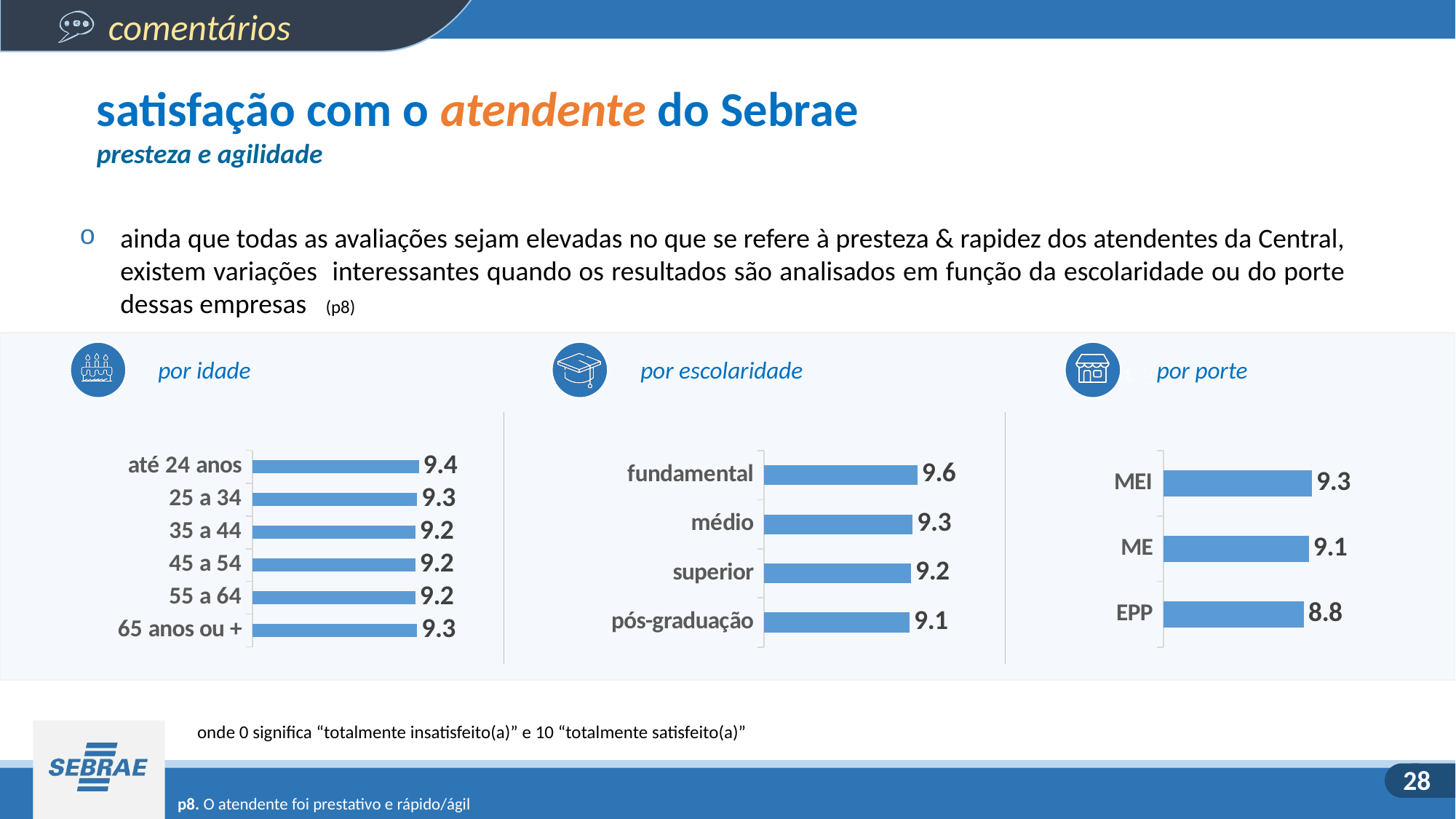
In the 'por idade' chart, which age group has the highest value? até 24 anos In the 'por escolaridade' chart, what is the difference between 'fundamental' and 'pós-graduação'? 0.5 In the 'por porte' chart, which is larger, the value for 'ME' or the value for 'EPP'? ME In the 'por idade' chart, what is the value for 'até 24 anos'? 9.4 In the 'por escolaridade' chart, do the values rise or fall from 'fundamental' to 'pós-graduação'? fall In the 'por porte' chart, what is the difference between 'MEI' and 'EPP'? 0.5 In the 'por escolaridade' chart, which category has the lowest value? pós-graduação In the 'por escolaridade' chart, what is the value for 'fundamental'? 9.6 What type of chart is the 'por porte' chart? bar chart In the 'por porte' chart, which category has the highest value? MEI In the 'por idade' chart, how many age categories are shown? 6 In the 'por porte' chart, what is the value for 'EPP'? 8.8